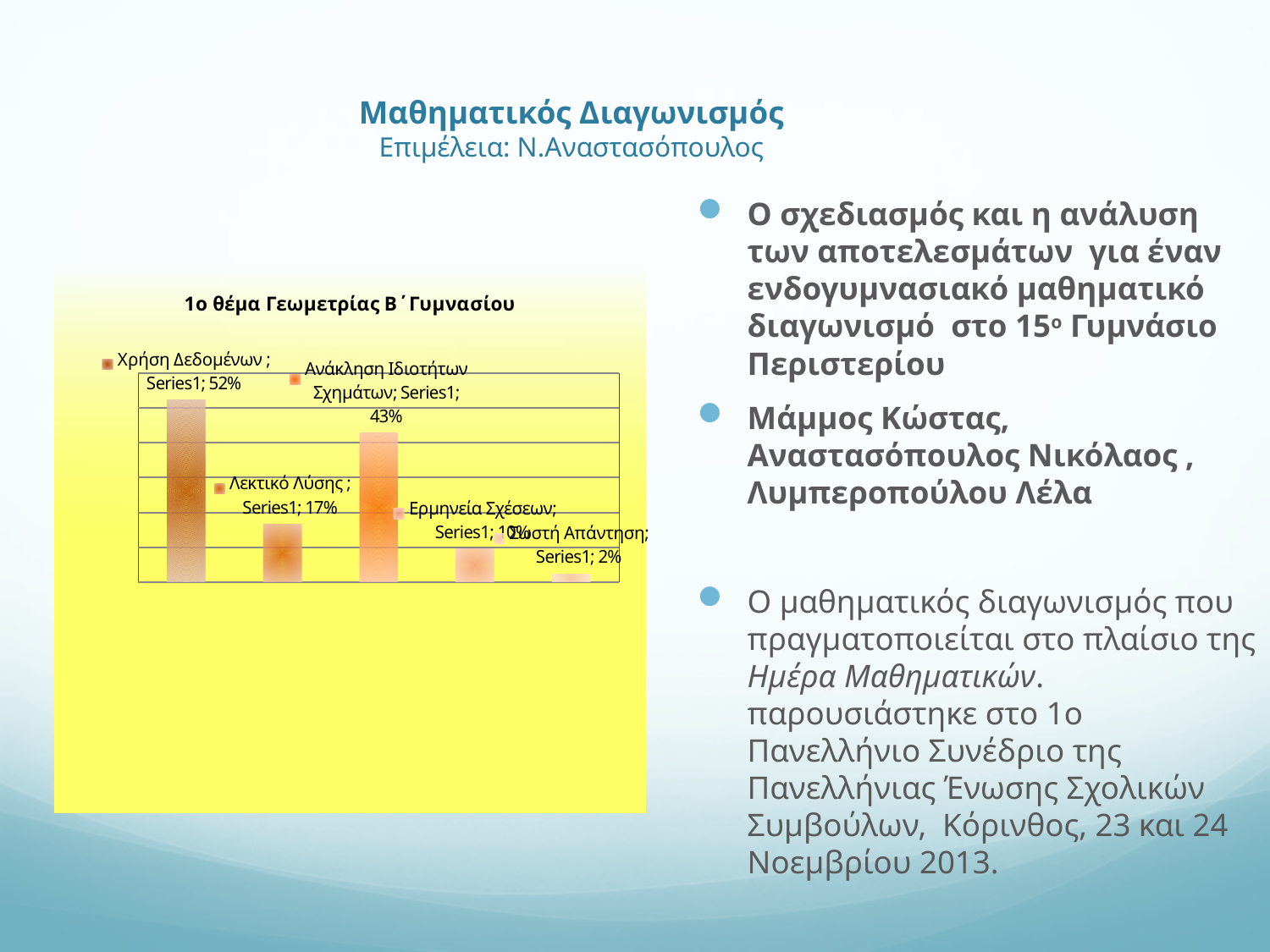
Do the values rise or fall from left to right across the categories? Neither; they fluctuate (52%, 17%, 43%, 10%, 2%) What is the title of the chart? 1ο θέμα Γεωμετρίας Β΄ Γυμνασίου What is the value for Ανάκληση Ιδιοτήτων Σχημάτων? 43% What type of chart is shown on the slide? bar chart What is the value for Λεκτικό Λύσης? 17% What is the value for Χρήση Δεδομένων? 52% Which category has the lowest value? Σωστή Απάντηση What is the difference between the values for Χρήση Δεδομένων and Ανάκληση Ιδιοτήτων Σχημάτων? 9% Which is larger, the value for Λεκτικό Λύσης or the value for Ερμηνεία Σχέσεων? Λεκτικό Λύσης What is the value for Σωστή Απάντηση? 2% How many categories (bars) are shown in the chart? 5 Which category has the highest value? Χρήση Δεδομένων